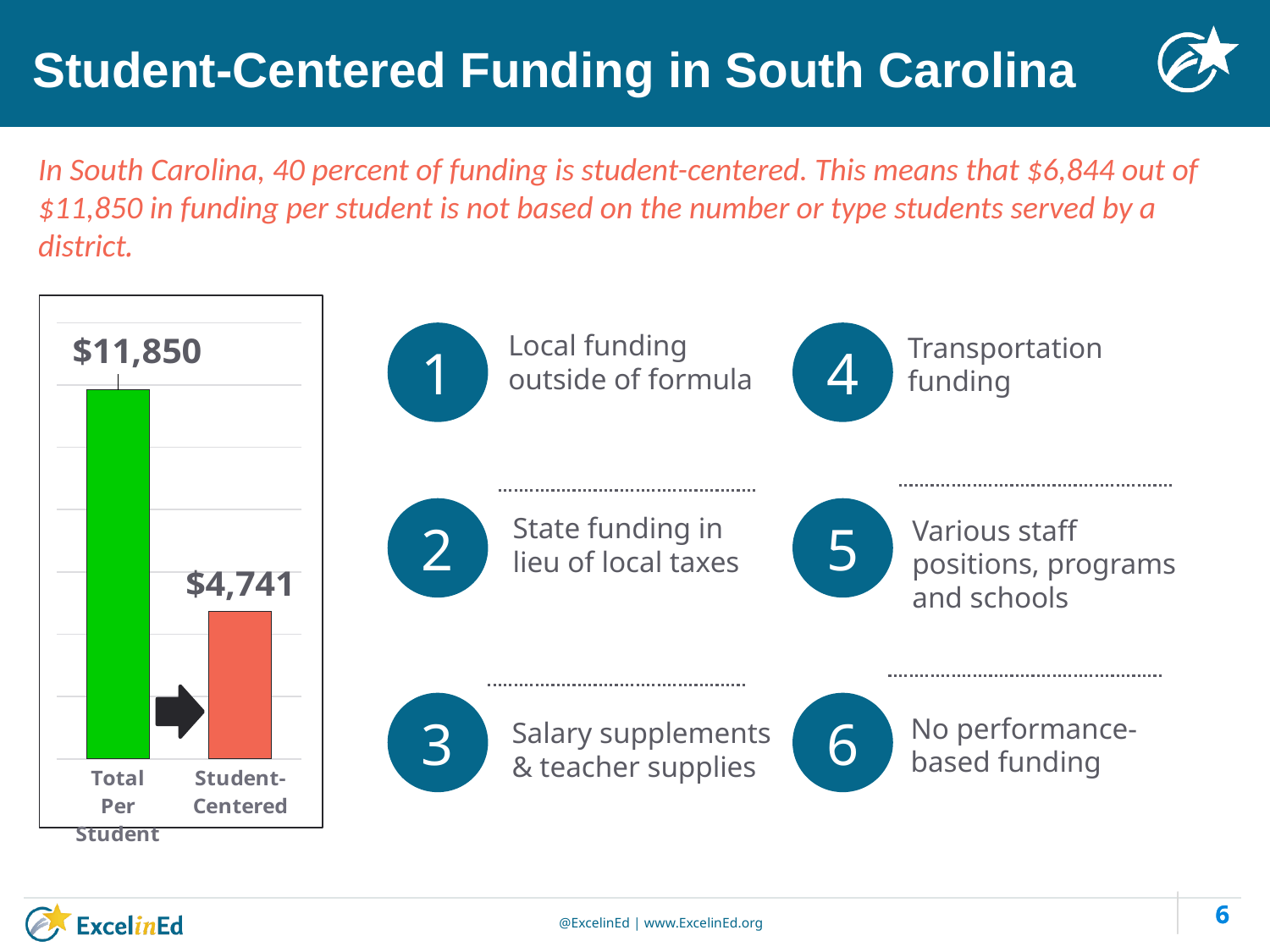
What is the difference between the Total Per Student value and the Student-Centered value in the bar chart? $7,109 How many bars are plotted in the chart? 2 What colour is the Student-Centered bar in the chart? Red What kind of chart is shown on the slide? Bar chart Do the values in the bar chart rise or fall from left to right? Fall What is the value shown for Student-Centered in the bar chart? $4,741 Which category in the bar chart has the highest value? Total Per Student What is the value shown for Total Per Student in the bar chart? $11,850 Which is larger in the bar chart, Total Per Student or Student-Centered? Total Per Student Which category in the bar chart has the lowest value? Student-Centered What colour is the Total Per Student bar in the chart? Green